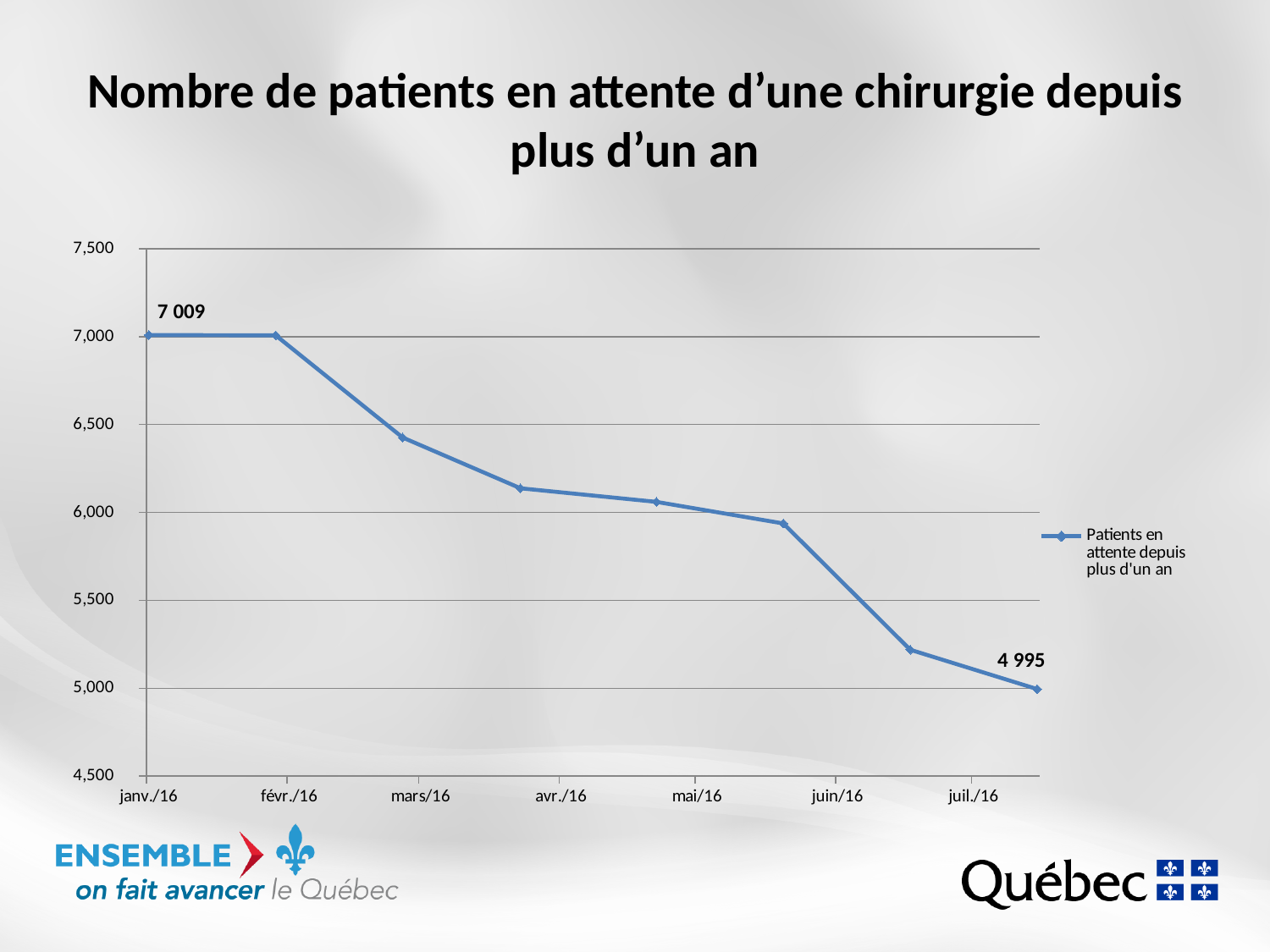
Which is larger, the value at janv./16 or the value at juil./16? janv./16 Is the value for févr./16 greater or less than 6,500? greater Is the value for mars/16 greater or less than 6,500? less How many series does the legend list? 1 What is the difference between the first labelled value (7 009) and the last labelled value (4 995)? 2 014 What is the lowest value shown on the line? 4 995 What is the value of the last data point on the line? 4 995 What is the legend entry for the series? Patients en attente depuis plus d'un an How many data points are plotted on the line? 8 What kind of chart is shown on the slide? line chart Do the values rise or fall from janv./16 to juil./16? fall What is the value of the first data point (janv./16)? 7 009